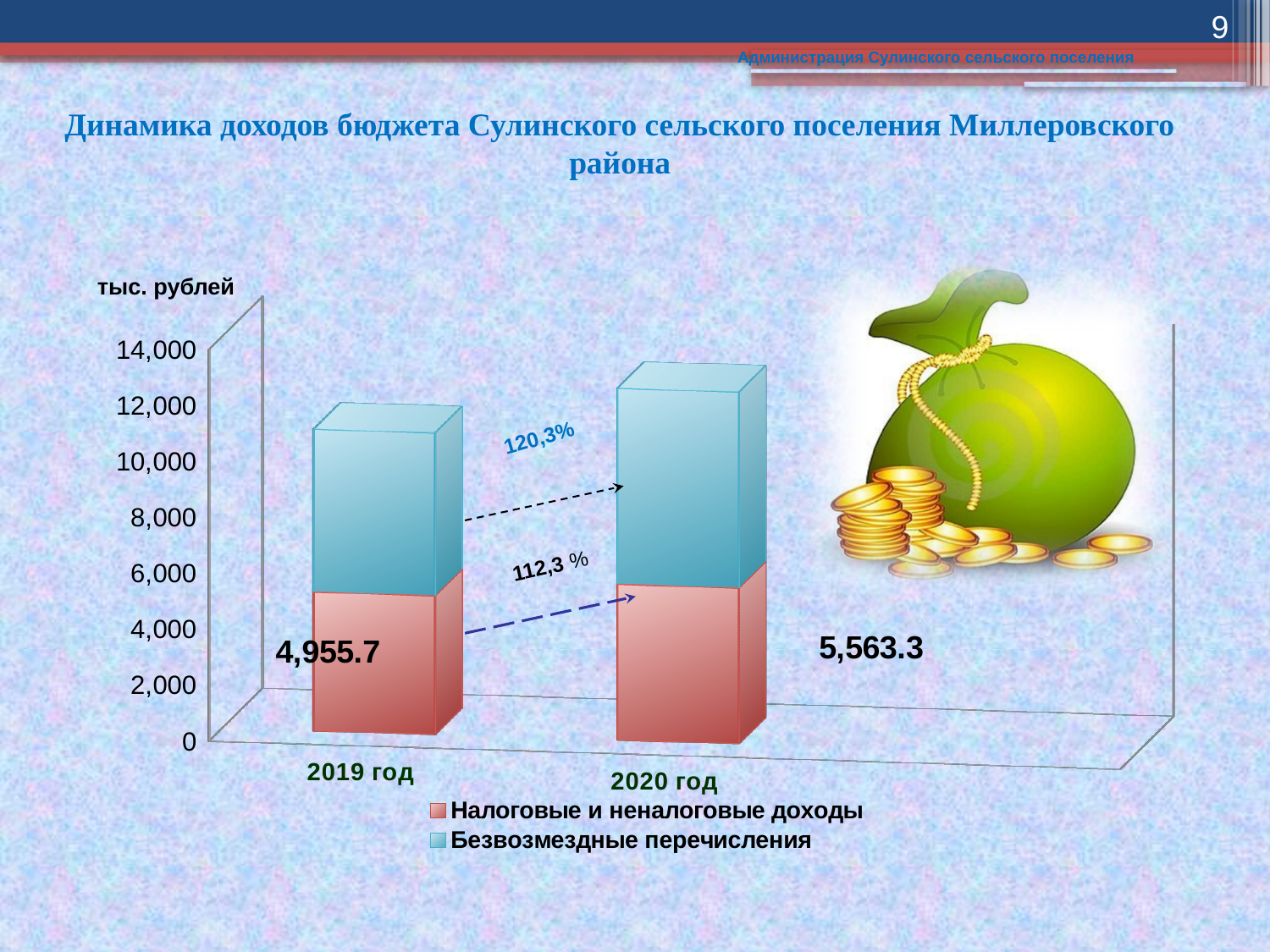
Is the total height of the stacked bar for 2019 год greater or less than 8,000? greater Is the total height of the stacked bar for 2019 год greater or less than 14,000? less What is the value of Налоговые и неналоговые доходы for 2020 год? 5,563.3 How many series does the chart legend list? 2 How many years (categories) are shown on the x axis of the chart? 2 Do the Налоговые и неналоговые доходы values rise or fall from 2019 год to 2020 год? Rise What is the difference between the Налоговые и неналоговые доходы values for 2020 год and 2019 год? 607.6 What kind of chart is shown on the slide? Stacked bar chart What unit is indicated above the vertical axis of the chart? тыс. рублей What is the value of Налоговые и неналоговые доходы for 2019 год? 4,955.7 Is the total height of the stacked bar for 2020 год greater or less than 10,000? greater Which year has the higher value for Налоговые и неналоговые доходы, 2019 год or 2020 год? 2020 год